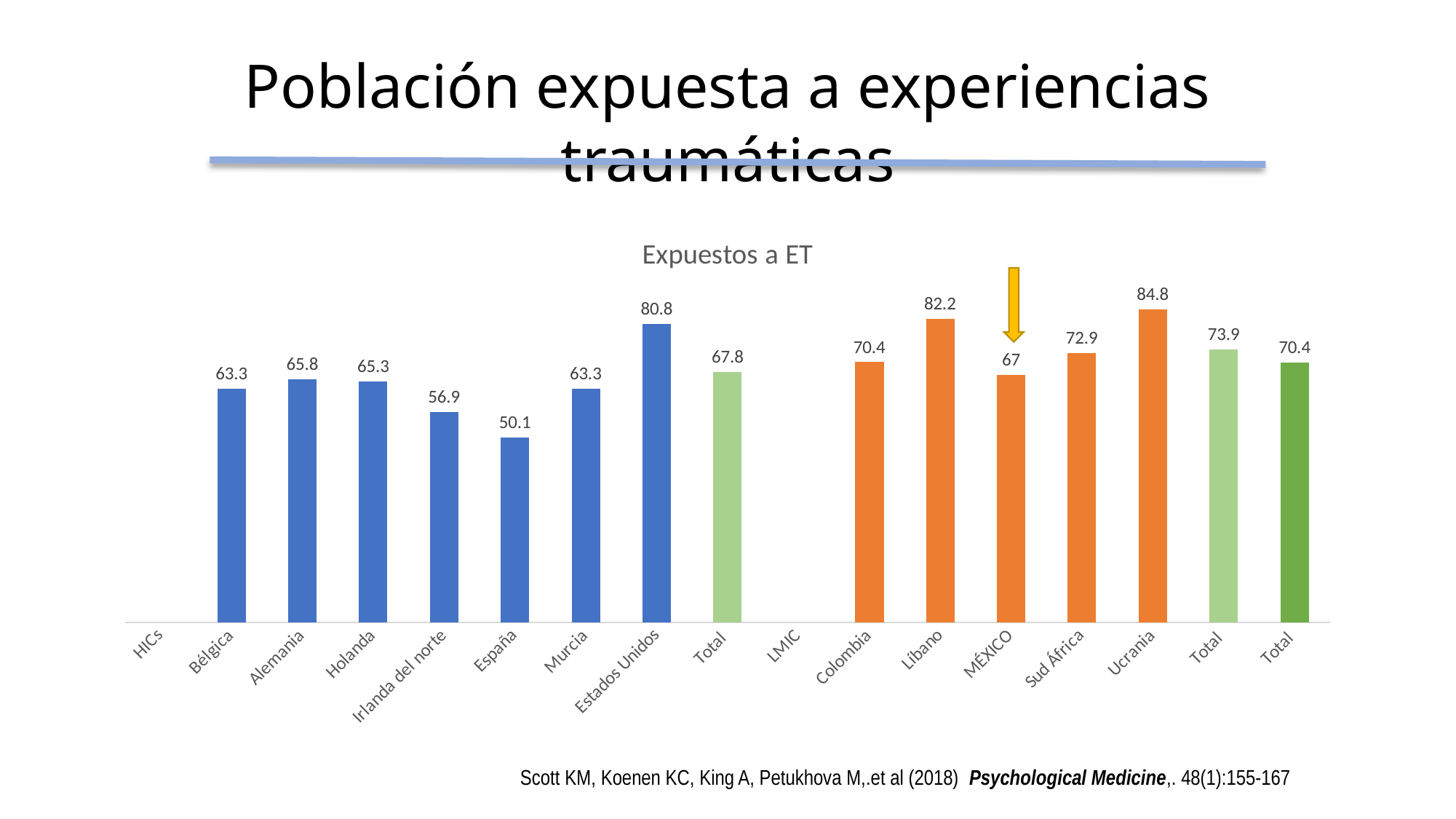
What is the difference between the values for Estados Unidos and España? 30.7 What is the value shown for Sud África? 72.9 What is the value shown for Irlanda del norte? 56.9 Which category has the lowest value in the chart? España Which category has the highest value in the chart? Ucrania What is the value shown for Ucrania? 84.8 What is the difference between the values for Líbano and Colombia? 11.8 What is the value shown for MÉXICO? 67 Which has a larger value, Estados Unidos or Líbano? Líbano What kind of chart is shown on the slide? Bar chart How many bars are plotted in the chart? 15 Which category is marked with a yellow arrow above its bar? MÉXICO